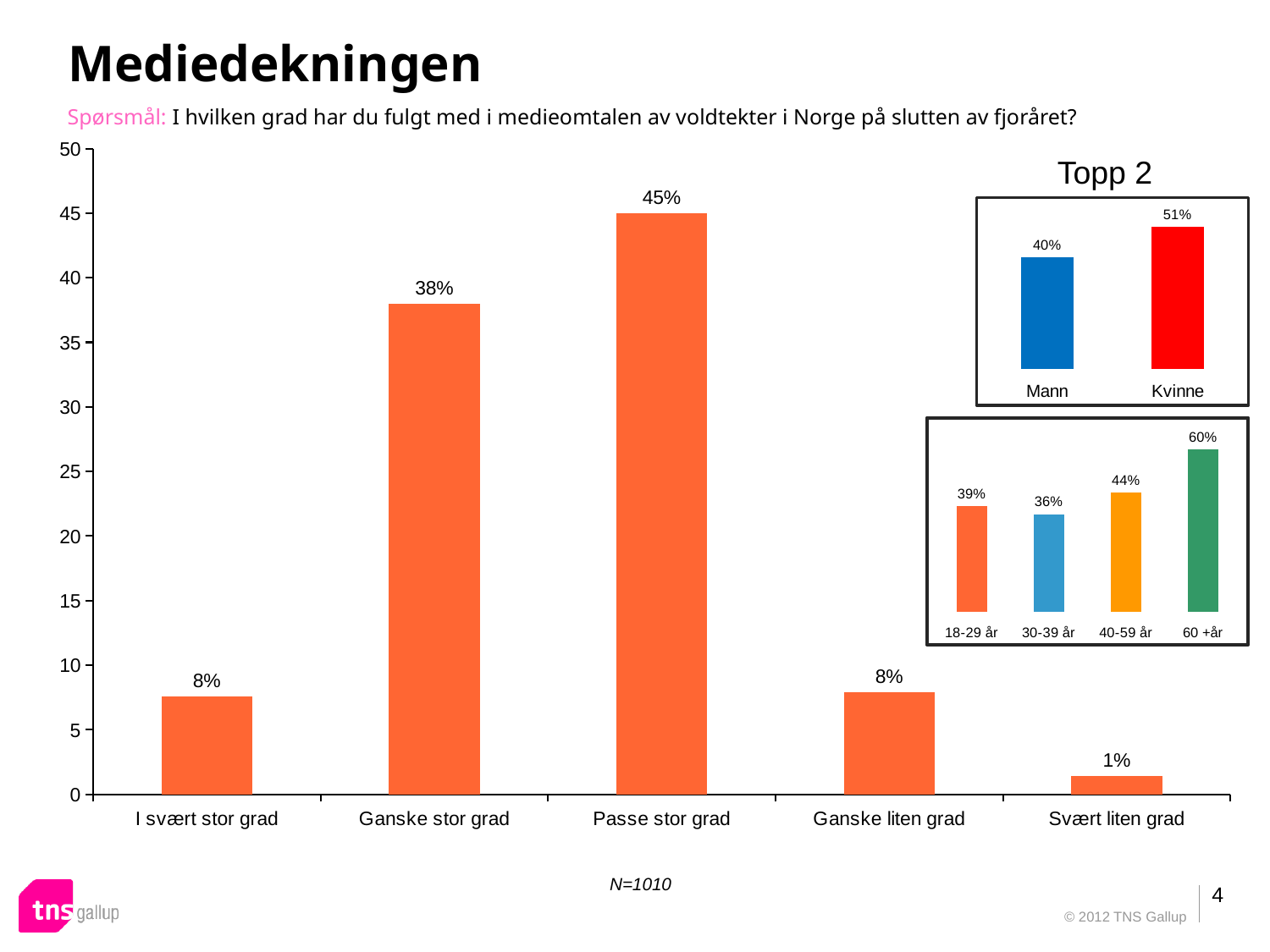
In the "Topp 2" chart, what is the value for Kvinne? 51% In the main bar chart, which category has the highest value? Passe stor grad In the age-group chart at the lower right, what is the difference between 60 +år and 18-29 år? 21% In the "Topp 2" chart, which is larger, Mann or Kvinne? Kvinne In the age-group chart at the lower right, which age group has the highest value? 60 +år In the main bar chart, what is the difference between "Passe stor grad" and "Ganske stor grad"? 7% In the main bar chart, which category has the lowest value? Svært liten grad How many categories are shown in the main bar chart? 5 In the main bar chart, what is the value for "Passe stor grad"? 45% In the age-group chart at the lower right, what is the value for 30-39 år? 36% What kind of chart is the main chart on the slide? Bar chart In the main bar chart, what is the value for "Ganske stor grad"? 38%